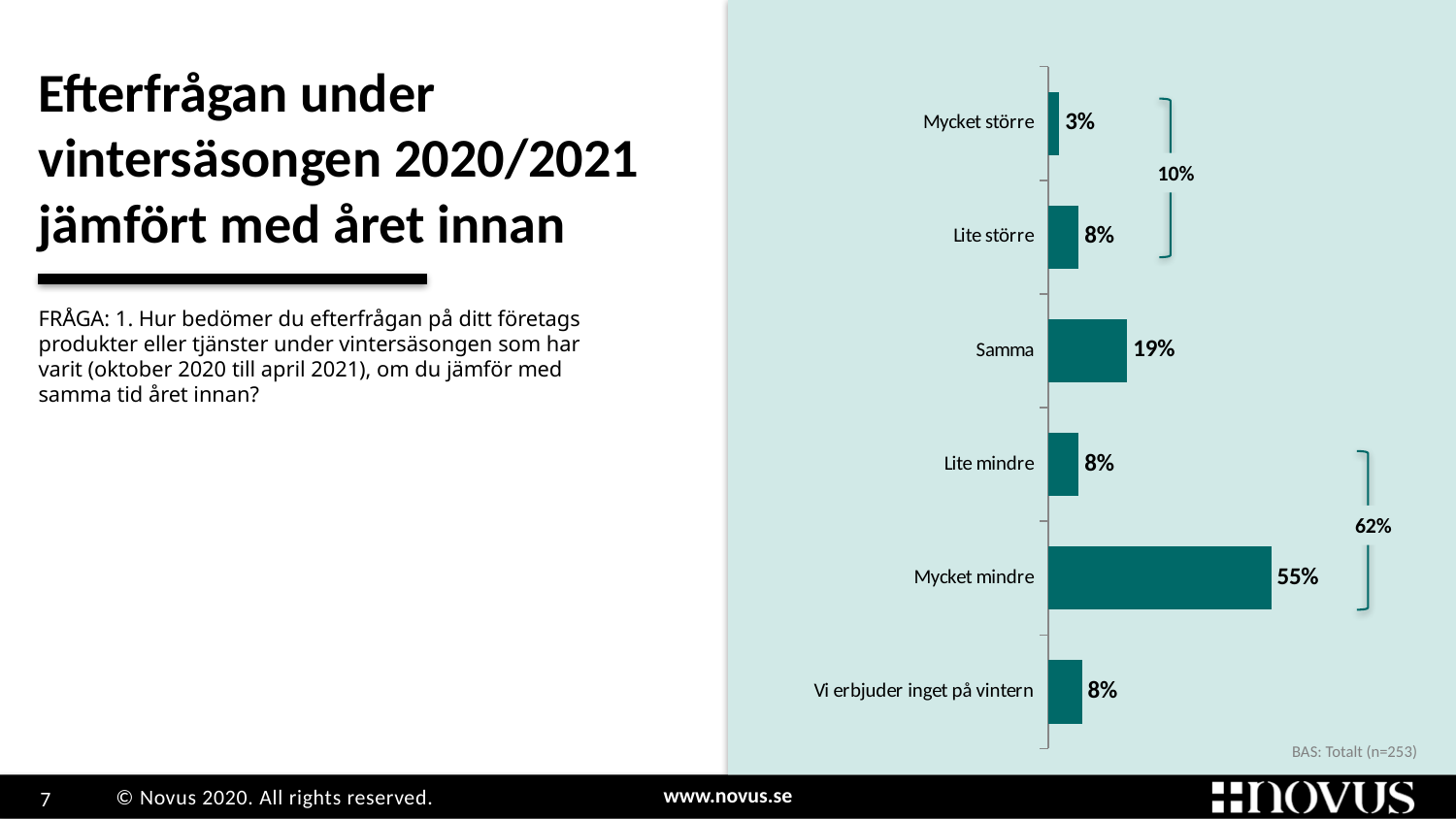
Which is larger, the value for "Samma" or the value for "Lite större"? Samma What is the difference between the values for "Mycket mindre" and "Samma"? 36% What combined percentage is shown by the bracket grouping "Lite mindre" and "Mycket mindre"? 62% Which category has the highest value? Mycket mindre What is the value for "Samma"? 19% What is the value for "Mycket större"? 3% What kind of chart is shown on the slide? Bar chart How many categories are shown in the chart? 6 What is the value for "Mycket mindre"? 55% Which category has the lowest value? Mycket större What combined percentage is shown by the bracket grouping "Mycket större" and "Lite större"? 10% What is the value for "Vi erbjuder inget på vintern"? 8%